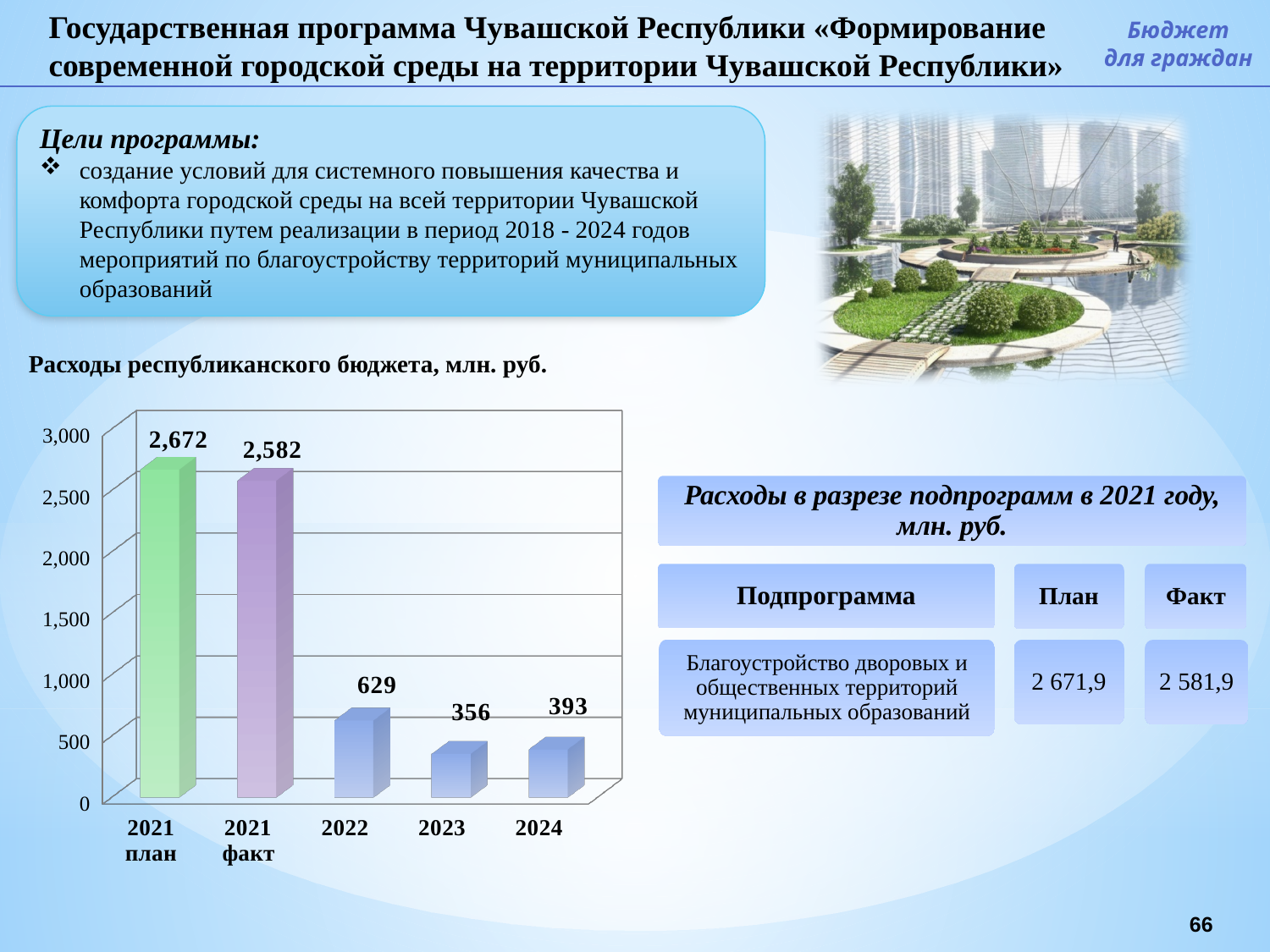
Is the value for 2022 in the chart 'Расходы республиканского бюджета, млн. руб.' greater or less than 500? greater Which category has the highest value in the chart 'Расходы республиканского бюджета, млн. руб.'? 2021 план How many bars are shown in the chart 'Расходы республиканского бюджета, млн. руб.'? 5 What is the value for 2024 in the chart 'Расходы республиканского бюджета, млн. руб.'? 393 What is the value for 2021 факт in the chart 'Расходы республиканского бюджета, млн. руб.'? 2,582 What kind of chart is 'Расходы республиканского бюджета, млн. руб.'? bar chart Which category has the lowest value in the chart 'Расходы республиканского бюджета, млн. руб.'? 2023 What is the difference between the 2021 план and 2021 факт values in the chart 'Расходы республиканского бюджета, млн. руб.'? 90 What is the value for 2021 план in the chart 'Расходы республиканского бюджета, млн. руб.'? 2,672 What is the value for 2023 in the chart 'Расходы республиканского бюджета, млн. руб.'? 356 In the chart 'Расходы республиканского бюджета, млн. руб.', which is larger: the value for 2022 or the value for 2024? 2022 What is the value for 2022 in the chart 'Расходы республиканского бюджета, млн. руб.'? 629